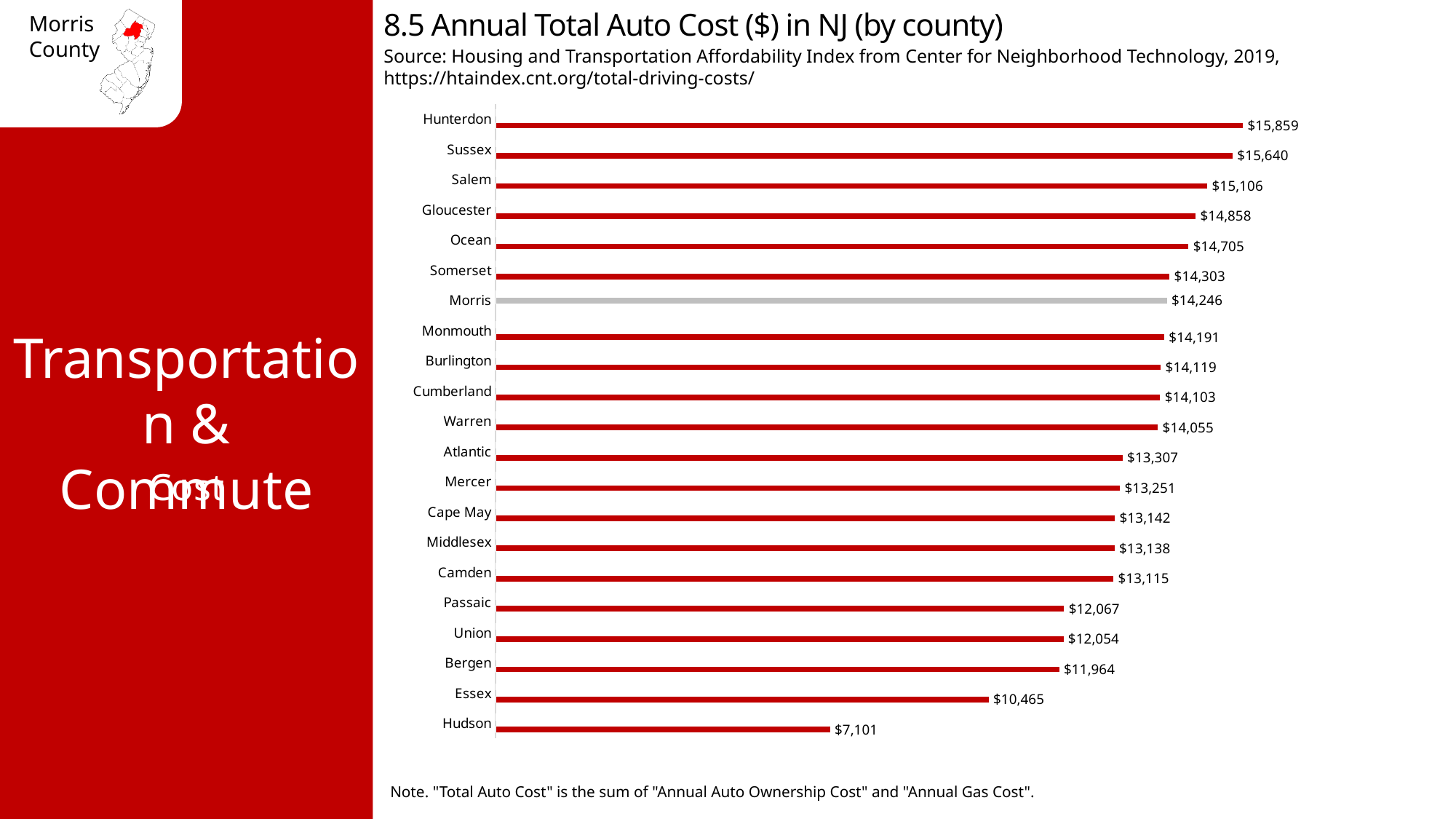
What type of chart is used to show annual total auto cost by county? Bar chart What is the annual total auto cost for Ocean County? $14,705 What is the difference in annual total auto cost between Somerset and Morris? $57 What is the title of the chart? 8.5 Annual Total Auto Cost ($) in NJ (by county) How many counties are shown in the chart? 21 What is the annual total auto cost for Morris County? $14,246 What is the annual total auto cost for Hudson County? $7,101 Which county has a higher annual total auto cost, Essex or Bergen? Bergen What is the difference in annual total auto cost between Hunterdon and Hudson? $8,758 Which county has the highest annual total auto cost? Hunterdon Which county's bar is shown in a different colour (grey) from the others? Morris Which county has the lowest annual total auto cost? Hudson